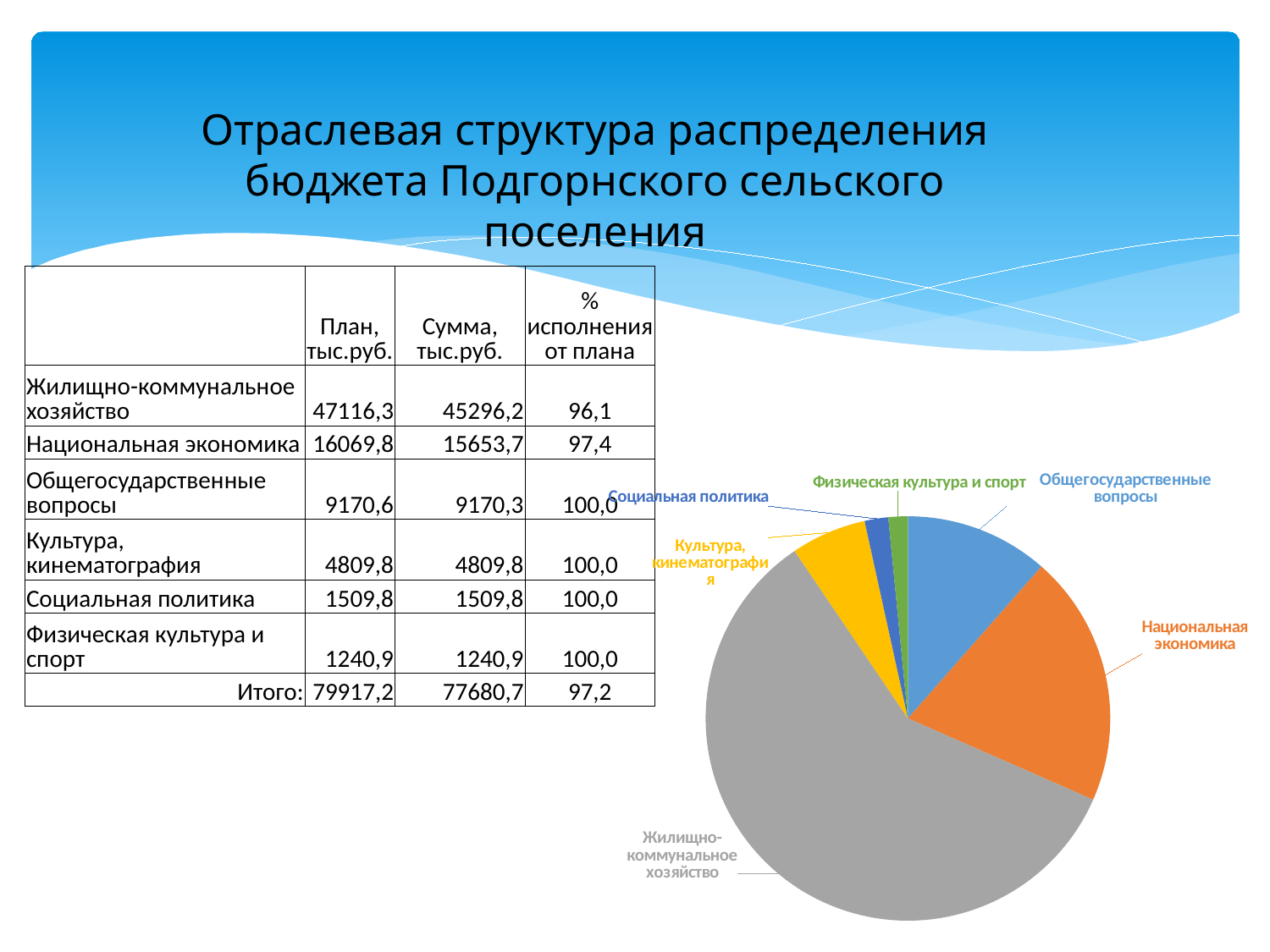
Which slice is larger in the pie chart: Общегосударственные вопросы or Физическая культура и спорт? Общегосударственные вопросы Which slice is larger in the pie chart: Жилищно-коммунальное хозяйство or Национальная экономика? Жилищно-коммунальное хозяйство What colour is the Жилищно-коммунальное хозяйство slice in the pie chart? grey Which slice is larger in the pie chart: Национальная экономика or Общегосударственные вопросы? Национальная экономика Which category in the pie chart is shown in orange? Национальная экономика Which category has the largest slice in the pie chart? Жилищно-коммунальное хозяйство How many categories (slices) does the pie chart have? 6 What kind of chart is shown on the slide? pie chart